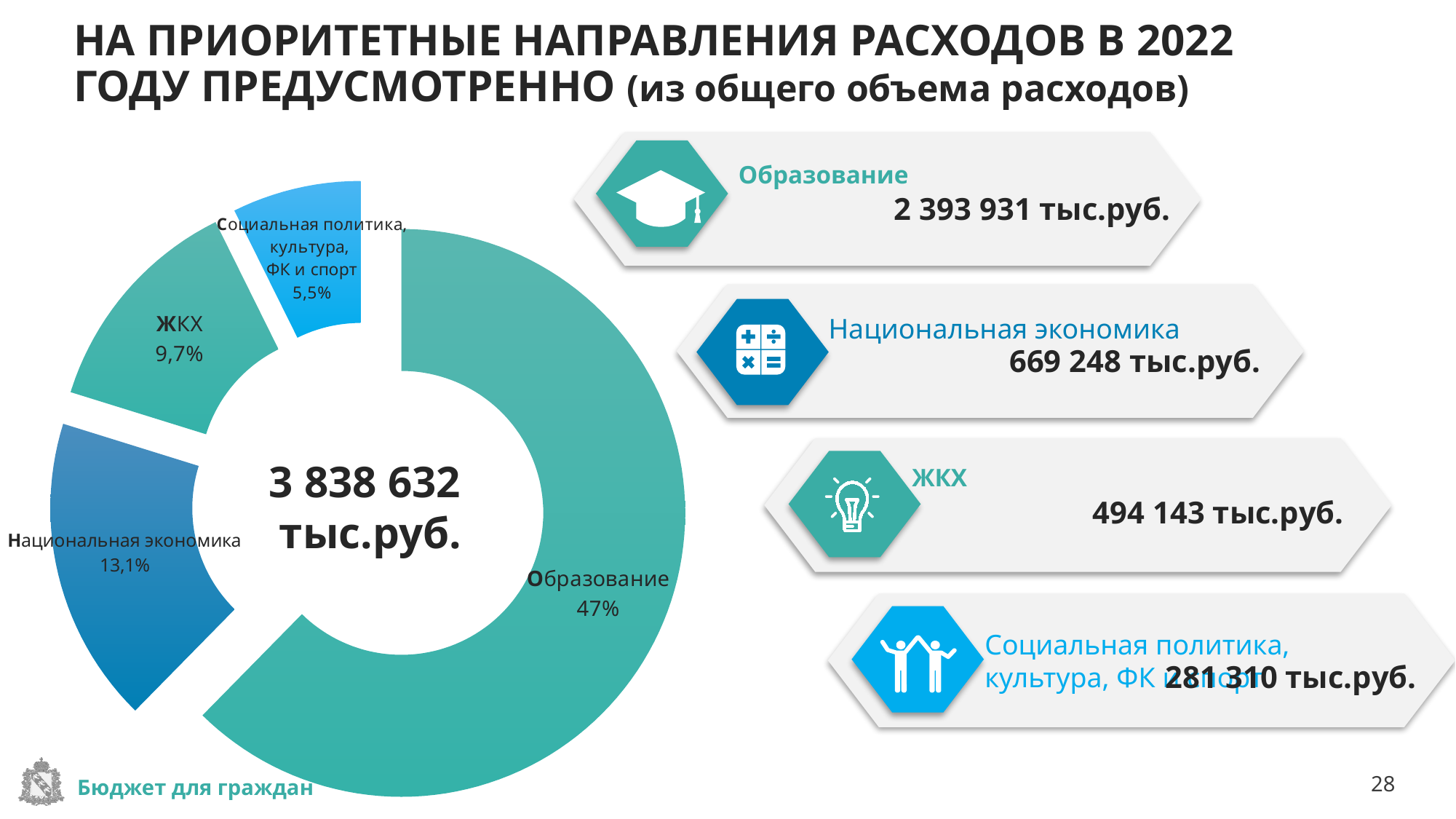
By how many percentage points does the ЖКХ slice exceed the Социальная политика, культура, ФК и спорт slice? 4,2 Which slice is larger in the donut chart: Национальная экономика or ЖКХ? Национальная экономика What share of the donut chart is labelled for Образование? 47% What total value is printed in the centre of the donut chart? 3 838 632 тыс.руб. What percentage is shown for Социальная политика, культура, ФК и спорт in the donut chart? 5,5% Which category has the largest slice in the donut chart? Образование How many labelled categories does the donut chart show? 4 What type of chart is shown on the slide? Donut (pie) chart By how many percentage points does the Образование slice exceed the Национальная экономика slice? 33,9 Which category has the smallest slice in the donut chart? Социальная политика, культура, ФК и спорт What percentage is shown for ЖКХ in the donut chart? 9,7% What percentage is shown for Национальная экономика in the donut chart? 13,1%